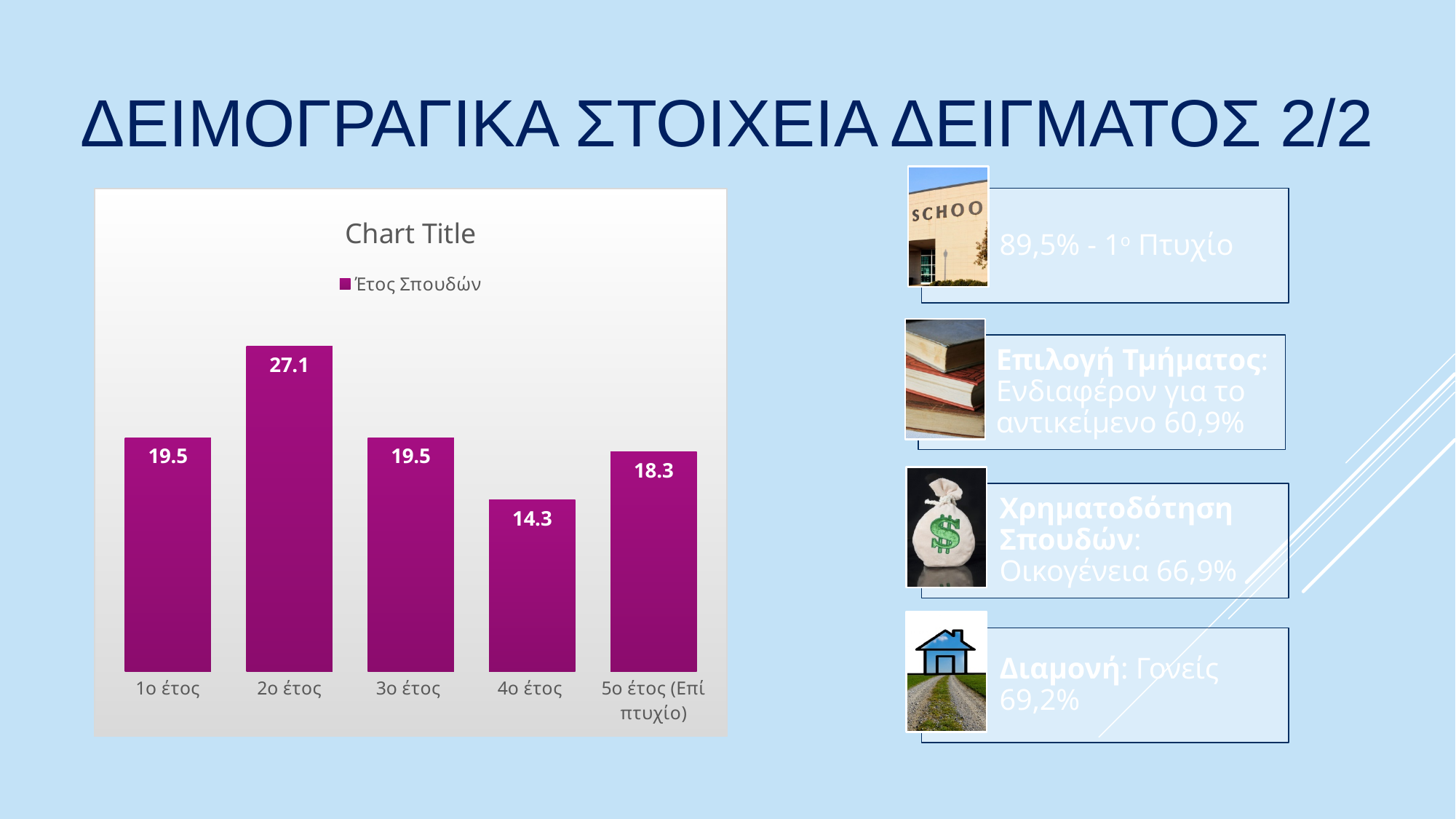
What is the difference between the values for 2ο έτος and 4ο έτος? 12.8 How many series does the legend list? 1 What is the value for 4ο έτος? 14.3 What is the legend entry of the chart? Έτος Σπουδών Which category has the highest value? 2ο έτος What is the value for 2ο έτος? 27.1 What kind of chart is shown? bar chart Which is larger, the value for 3ο έτος or the value for 5ο έτος (Επί πτυχίο)? 3ο έτος What is the value for 1ο έτος? 19.5 What is the value for 5ο έτος (Επί πτυχίο)? 18.3 Which category has the lowest value? 4ο έτος How many categories are shown on the x axis? 5